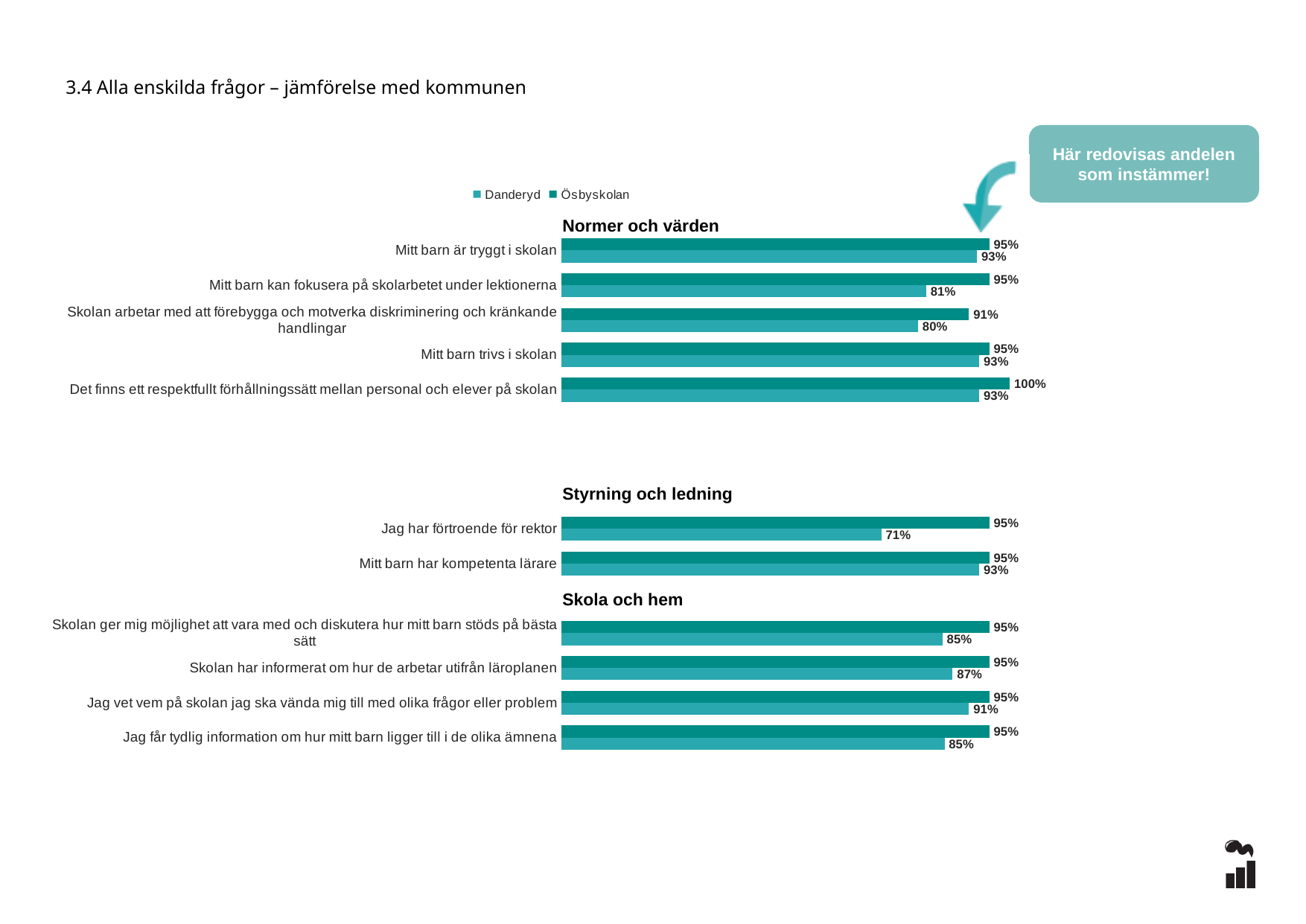
What is the Ösbyskolan value for 'Skolan arbetar med att förebygga och motverka diskriminering och kränkande handlingar'? 91% What is the difference between the Ösbyskolan and Danderyd values for 'Jag har förtroende för rektor'? 24% How many statements (categories) are plotted in total across the chart? 11 What is the Danderyd value for 'Jag har förtroende för rektor'? 71% What is the Ösbyskolan value for 'Det finns ett respektfullt förhållningssätt mellan personal och elever på skolan'? 100% Which two series are listed in the legend? Danderyd and Ösbyskolan Which statement has the highest Ösbyskolan value? Det finns ett respektfullt förhållningssätt mellan personal och elever på skolan What is the Danderyd value for 'Skolan har informerat om hur de arbetar utifrån läroplanen'? 87% Which statement has the lowest Danderyd value? Jag har förtroende för rektor For 'Mitt barn kan fokusera på skolarbetet under lektionerna', which is larger, the Ösbyskolan value or the Danderyd value? Ösbyskolan What kind of chart is shown on the slide? bar chart How many series does the legend list? 2